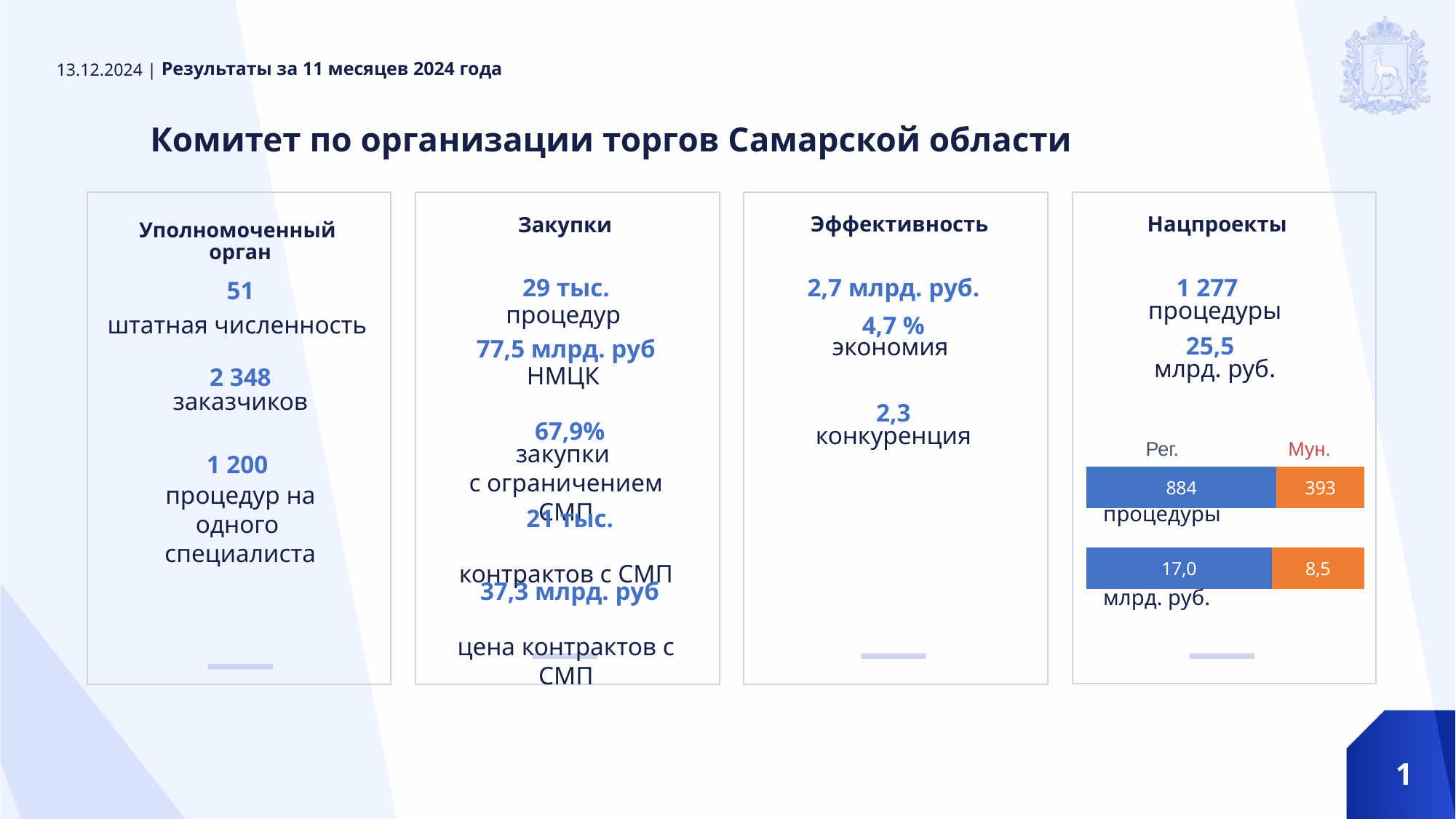
In the Нацпроекты chart, what is the Рег. value for процедуры? 884 In the Нацпроекты chart, what is the total of the stacked bar for млрд. руб.? 25,5 In the Нацпроекты chart, what is the difference between the Рег. and Мун. values for млрд. руб.? 8,5 How many stacked bars are shown in the Нацпроекты chart? 2 In the Нацпроекты chart, what is the Мун. value for млрд. руб.? 8,5 In the Нацпроекты chart, what is the Рег. value for млрд. руб.? 17,0 In the Нацпроекты chart, what is the total of the stacked bar for процедуры? 1 277 In the Нацпроекты chart, what is the difference between the Рег. and Мун. values for процедуры? 491 In the Нацпроекты chart, what is the Мун. value for процедуры? 393 How many series does the legend of the Нацпроекты chart list? 2 In the Нацпроекты chart, which series has the larger value for процедуры, Рег. or Мун.? Рег. What kind of chart is shown in the Нацпроекты panel? Stacked bar chart